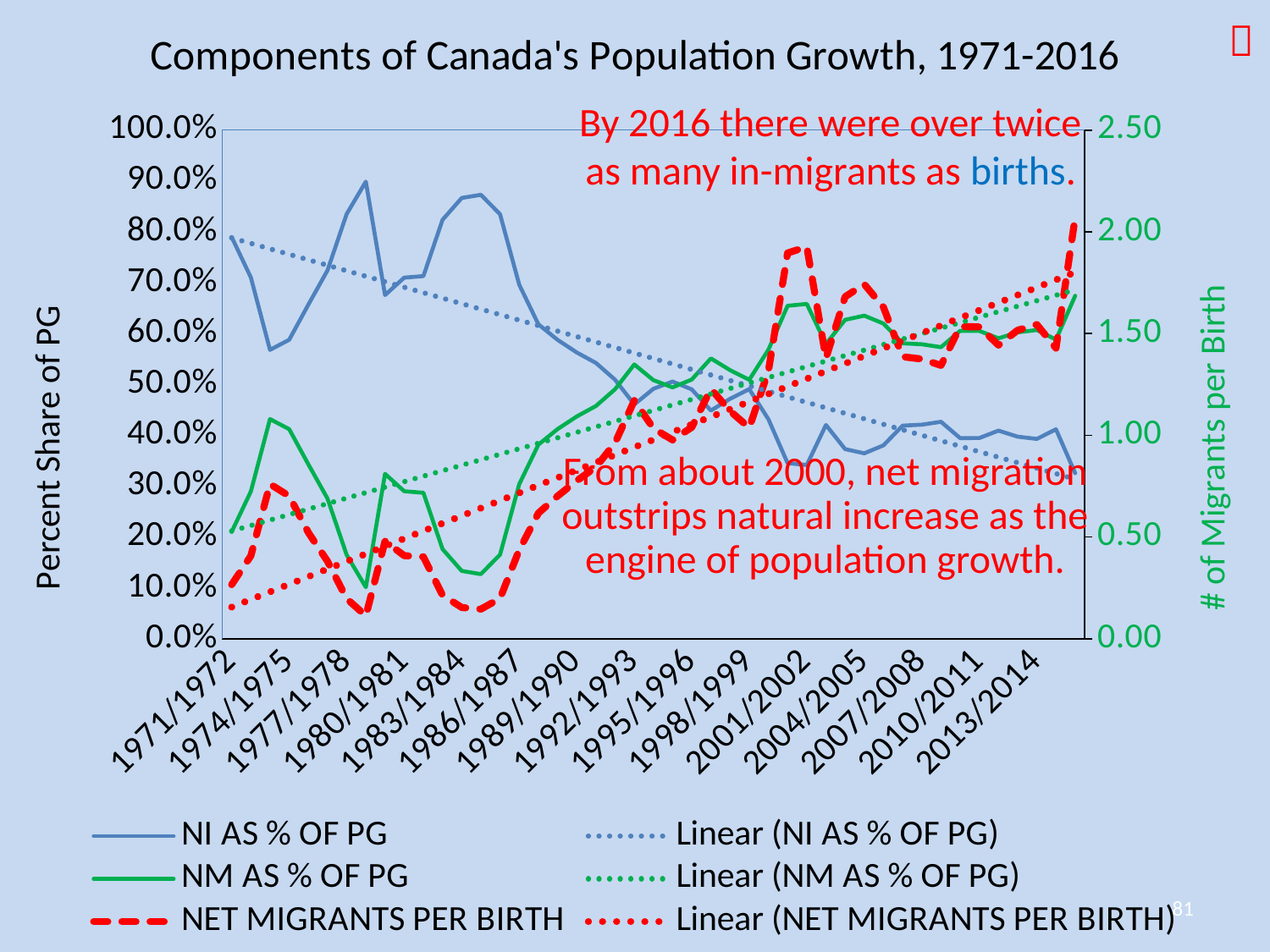
In 2013/2014, which is larger: NI AS % OF PG or NM AS % OF PG? NM AS % OF PG Is the value for NET MIGRANTS PER BIRTH in 2001/2002 greater or less than 1.50? greater Does the NI AS % OF PG series generally rise or fall from 1971/1972 to 2013/2014? fall Is the value for NI AS % OF PG in 1971/1972 greater or less than 70.0%? greater Is the value for NM AS % OF PG in 1971/1972 greater or less than 30.0%? less What is the title of the chart? Components of Canada's Population Growth, 1971-2016 How many series does the legend list? 6 Does the NM AS % OF PG series generally rise or fall from 1971/1972 to 2013/2014? rise In 1971/1972, which is larger: NI AS % OF PG or NM AS % OF PG? NI AS % OF PG What kind of chart is shown on the slide? line chart What is the label of the left vertical axis? Percent Share of PG